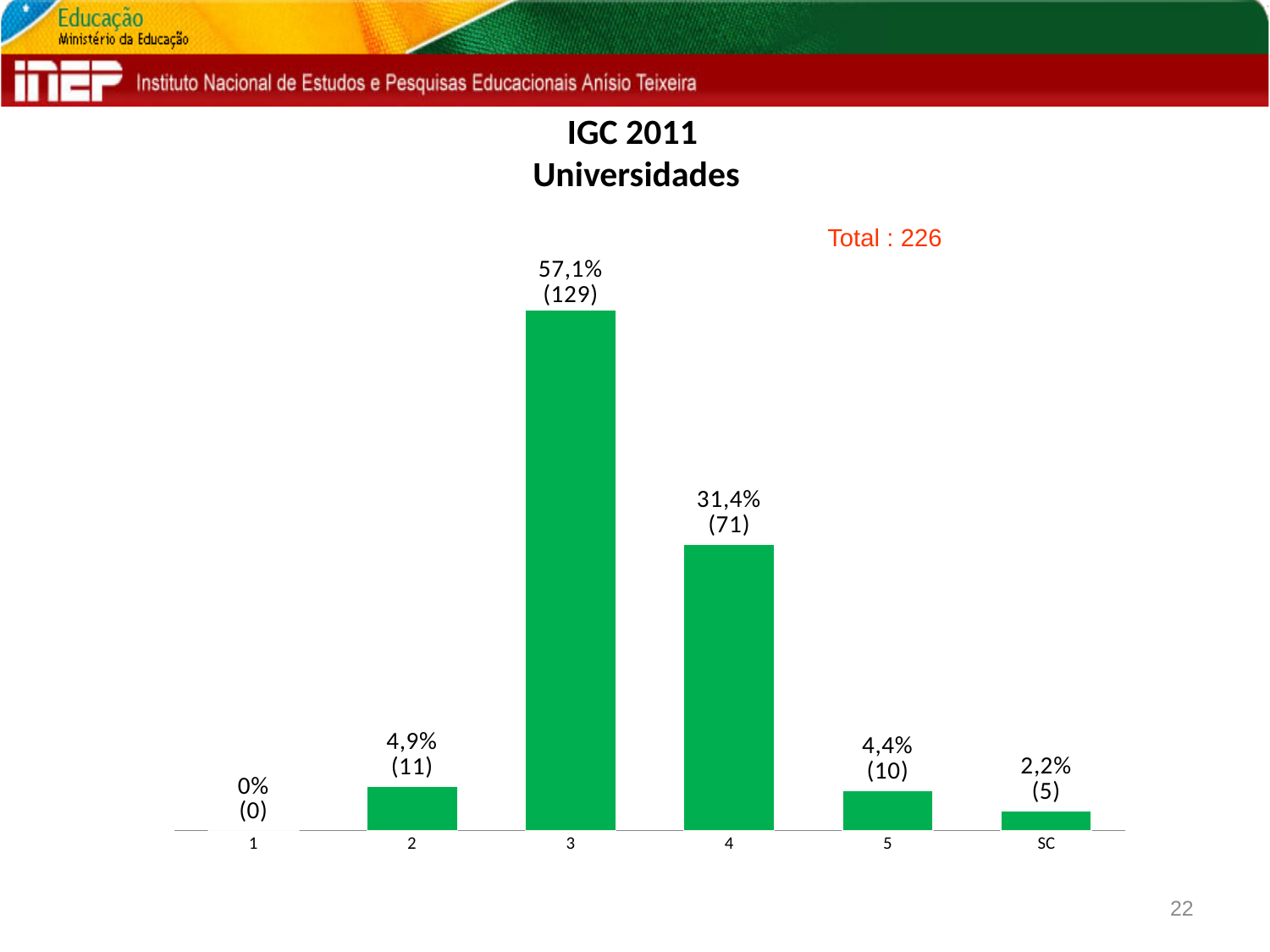
What count is shown in parentheses for category 4? 71 Which category has the highest value? 3 What kind of chart is shown? bar chart Which category has the lowest value? 1 What percentage is shown for category SC? 2,2% What count is shown in parentheses for category 2? 11 How many categories are shown on the x axis? 6 What percentage is shown for category 3? 57,1% Which has a larger value, category 2 or category 5? 2 What is the difference in counts between category 3 and category 4? 58 What is the title of the chart? IGC 2011 Universidades What total is stated on the slide? 226